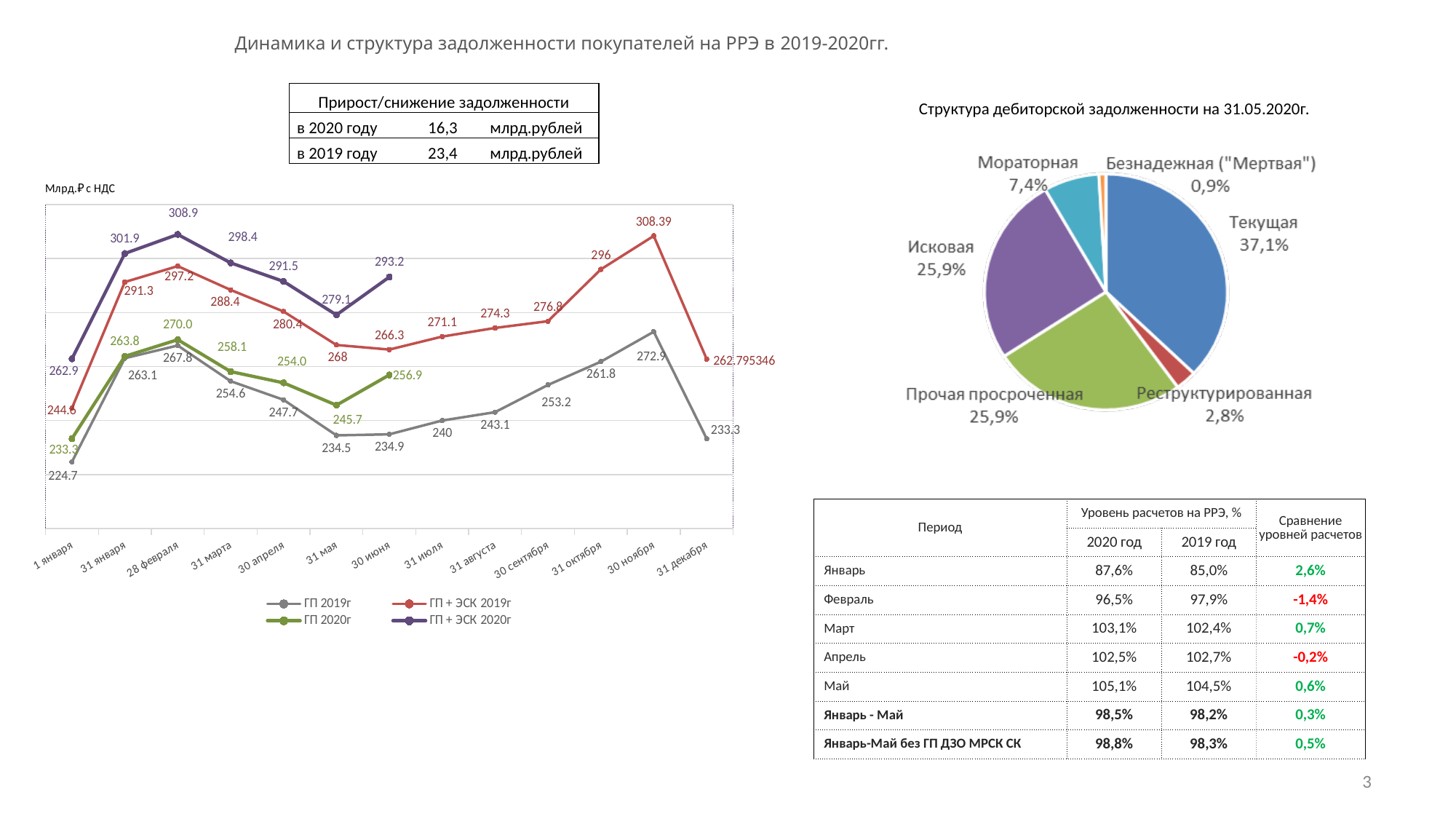
What kind of chart is the chart titled 'Структура дебиторской задолженности на 31.05.2020г.'? pie chart On the line chart on the left, what is the value of the ГП + ЭСК 2020г series on 28 февраля? 308.9 On the line chart on the left, what is the value of the ГП 2019г series on 31 мая? 234.5 On the line chart on the left, at which date does the ГП 2020г series reach its highest value? 28 февраля In the pie chart 'Структура дебиторской задолженности на 31.05.2020г.', how many slices are there? 6 On the line chart on the left, at which date is the ГП 2019г series lowest? 1 января On the line chart on the left, does the ГП + ЭСК 2020г series rise or fall from 28 февраля to 31 мая? fall On the line chart on the left, what is the value of the ГП + ЭСК 2019г series on 30 ноября? 308.39 In the pie chart 'Структура дебиторской задолженности на 31.05.2020г.', what share does Текущая have? 37,1% On the line chart on the left, which is larger on 31 марта: ГП 2020г or ГП 2019г? ГП 2020г On the line chart on the left, what is the difference between the ГП + ЭСК 2020г and ГП 2020г values on 30 июня? 36.3 On the line chart on the left, how many series does the legend list? 4